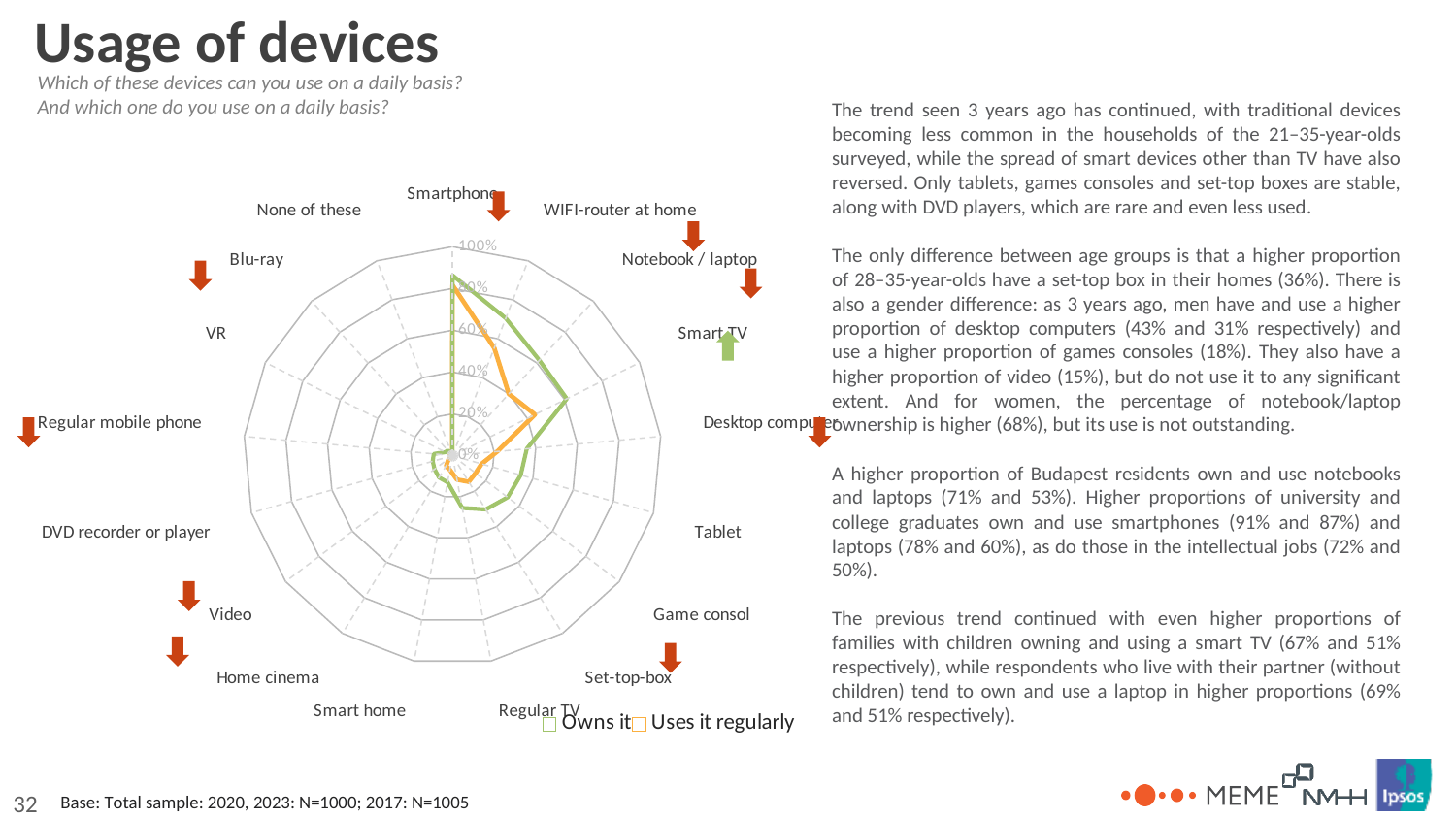
Which is larger: the 'Owns it' value for Smartphone or for VR? Smartphone How many series does the chart legend list? 2 Is the 'Uses it regularly' value for Smartphone greater or less than 60%? greater Is the 'Owns it' value for Smartphone greater or less than 80%? greater What are the two series named in the chart legend? Owns it; Uses it regularly Is the 'Owns it' value for Smart TV greater or less than 40%? greater Which device has the highest 'Owns it' value? Smartphone What kind of chart is shown on the slide? Radar chart What is the maximum value shown on the chart's percentage axis? 100% How many device categories are plotted around the radar chart? 17